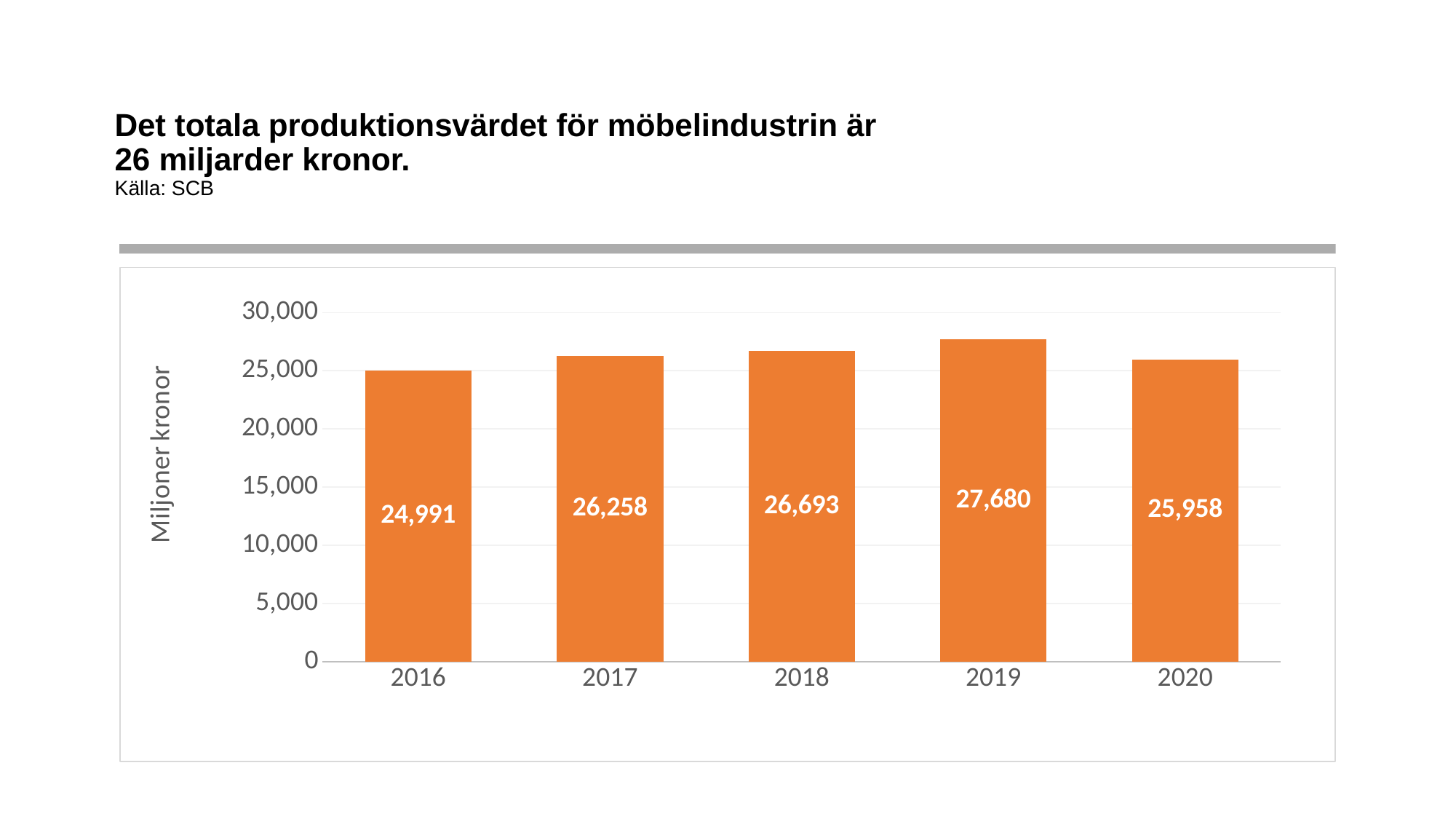
What is the value for 2020? 25,958 How many years are shown on the x axis? 5 What kind of chart is shown on the slide? bar chart What is the difference between the values for 2019 and 2016? 2,689 What is the value for 2019? 27,680 What is the value for 2016? 24,991 What is the label on the y axis? Miljoner kronor Which is larger, the value for 2018 or the value for 2020? 2018 Which year has the highest value? 2019 What is the difference between the values for 2018 and 2017? 435 Is the value for 2017 greater or less than 25,000? greater Which year has the lowest value? 2016